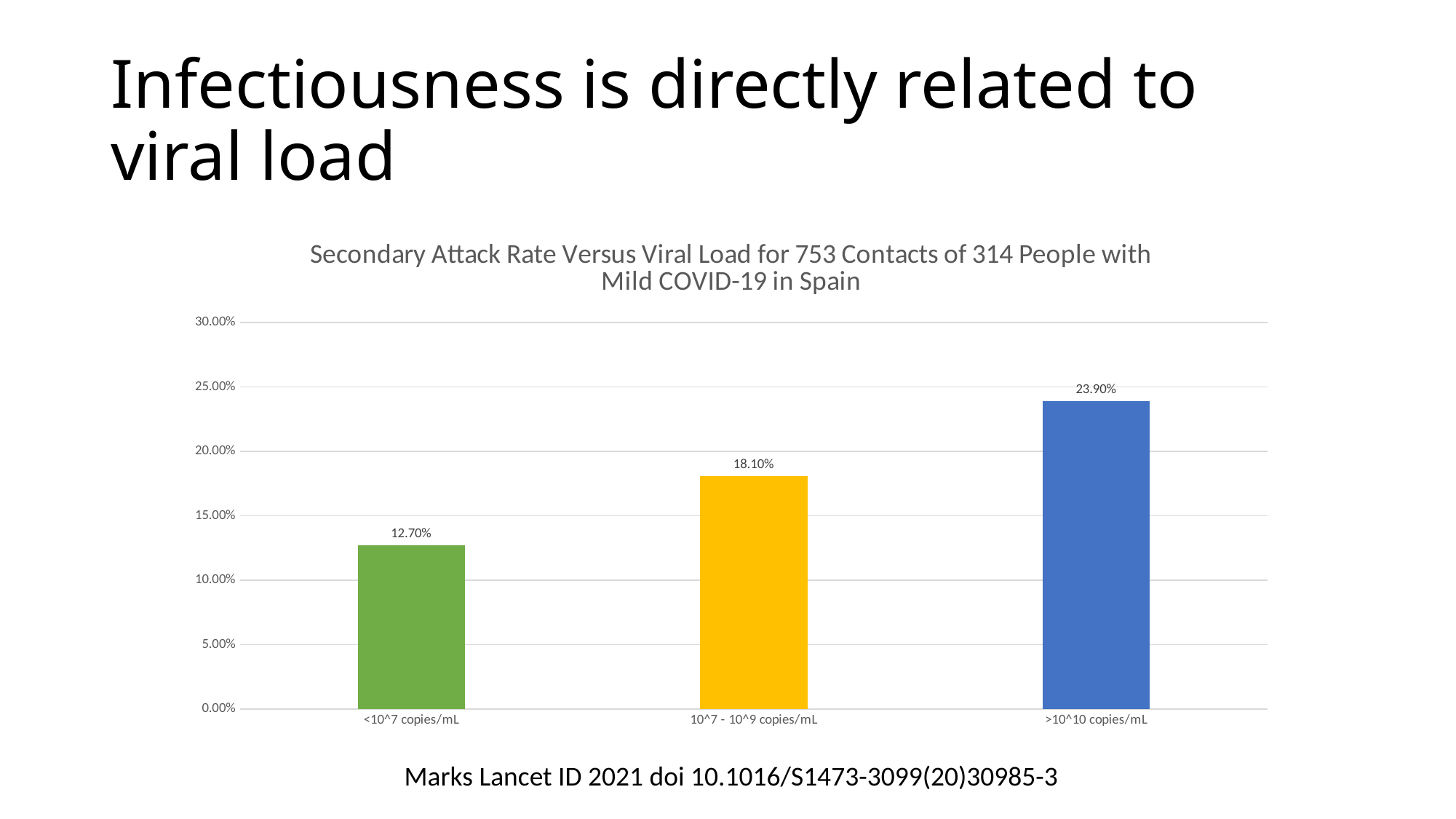
What is the difference between the secondary attack rate for >10^10 copies/mL and for <10^7 copies/mL? 11.20% What kind of chart is shown on the slide? Bar chart Which viral load category has the highest secondary attack rate? >10^10 copies/mL How many viral load categories are shown in the chart? 3 What is the secondary attack rate for the 10^7 - 10^9 copies/mL category? 18.10% What is the secondary attack rate for the >10^10 copies/mL category? 23.90% Do the secondary attack rates rise or fall as viral load increases along the x axis? Rise Which has a higher secondary attack rate, 10^7 - 10^9 copies/mL or >10^10 copies/mL? >10^10 copies/mL What is the secondary attack rate for the <10^7 copies/mL category? 12.70% Is the value for 10^7 - 10^9 copies/mL greater or less than 20.00%? less Which viral load category has the lowest secondary attack rate? <10^7 copies/mL What is the difference between the secondary attack rate for 10^7 - 10^9 copies/mL and for <10^7 copies/mL? 5.40%